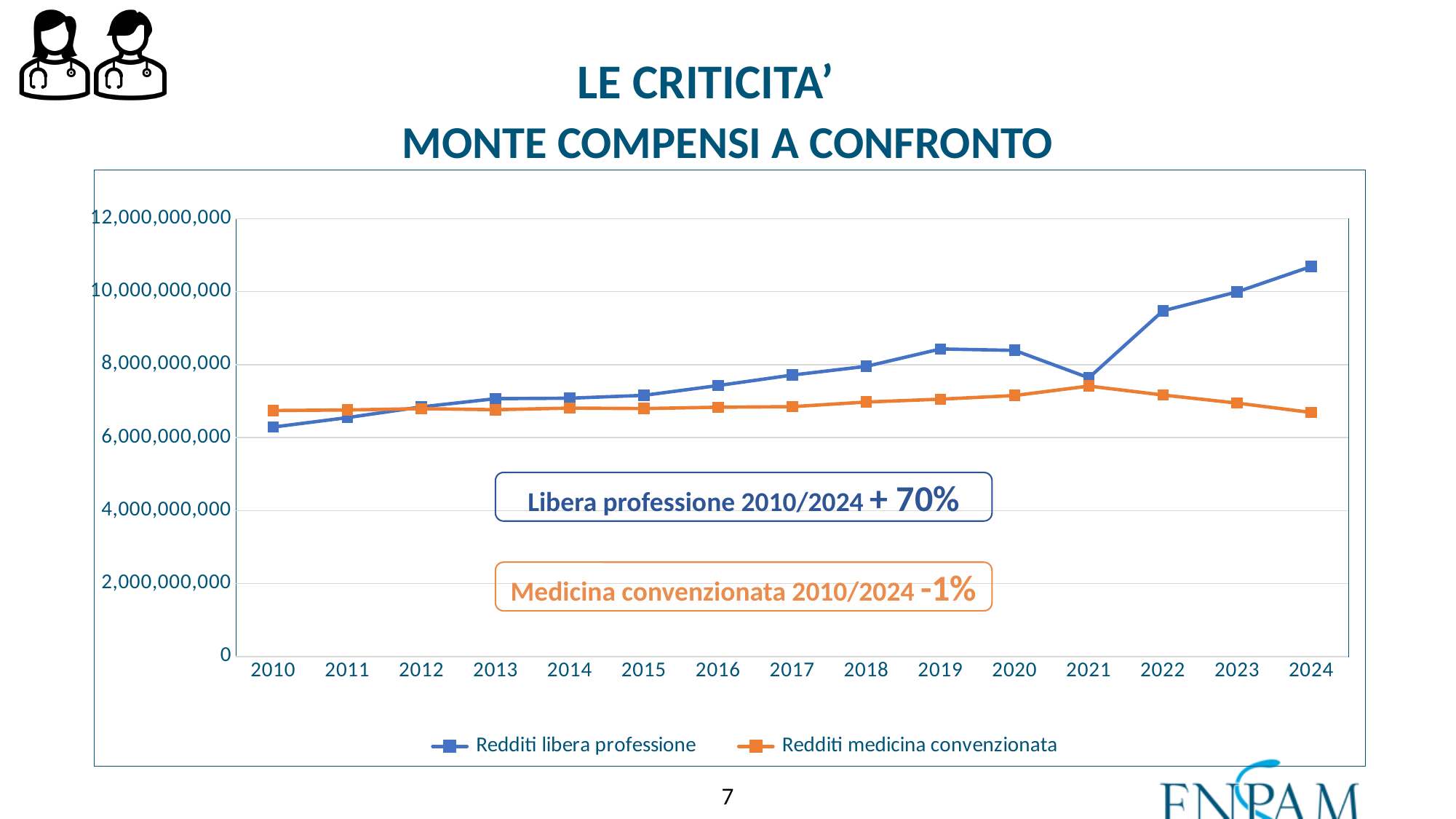
In which year is Redditi libera professione highest? 2024 In 2010, which series has the higher value, Redditi libera professione or Redditi medicina convenzionata? Redditi medicina convenzionata In which year is Redditi libera professione lowest? 2010 Is the value for Redditi medicina convenzionata in 2024 greater or less than 8,000,000,000? less How many years are plotted along the x axis? 15 In 2024, which series has the higher value, Redditi libera professione or Redditi medicina convenzionata? Redditi libera professione What percentage change does the slide show for Libera professione 2010/2024? + 70% How many series does the legend list? 2 Is the value for Redditi libera professione in 2024 greater or less than 10,000,000,000? greater What kind of chart is shown on the slide? line chart In which year is Redditi medicina convenzionata highest? 2021 Does Redditi libera professione rise or fall from 2021 to 2024? rise